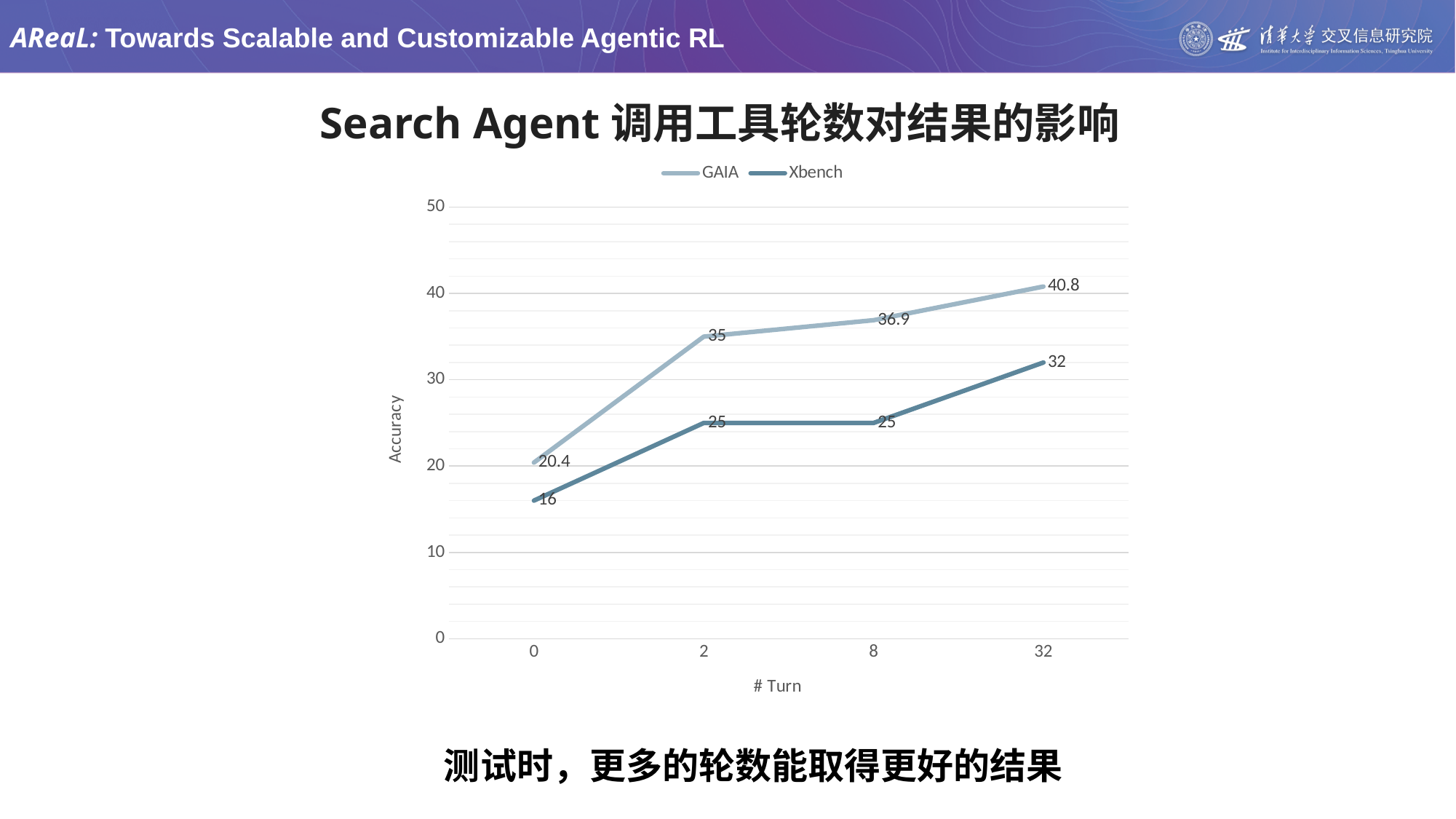
At which number of turns is Xbench accuracy lowest? 0 Does GAIA accuracy rise or fall as the number of turns increases? Rise What kind of chart is shown on the slide? Line chart What is the Xbench accuracy at 8 turns? 25 What is the GAIA accuracy at 2 turns? 35 Which series has the higher accuracy at 8 turns, GAIA or Xbench? GAIA What is the difference between GAIA accuracy at 32 turns and at 0 turns? 20.4 What is the GAIA accuracy at 32 turns? 40.8 What is the Xbench accuracy at 0 turns? 16 At which number of turns is GAIA accuracy highest? 32 How many turn settings are plotted on the x axis? 4 How many series does the legend list? 2